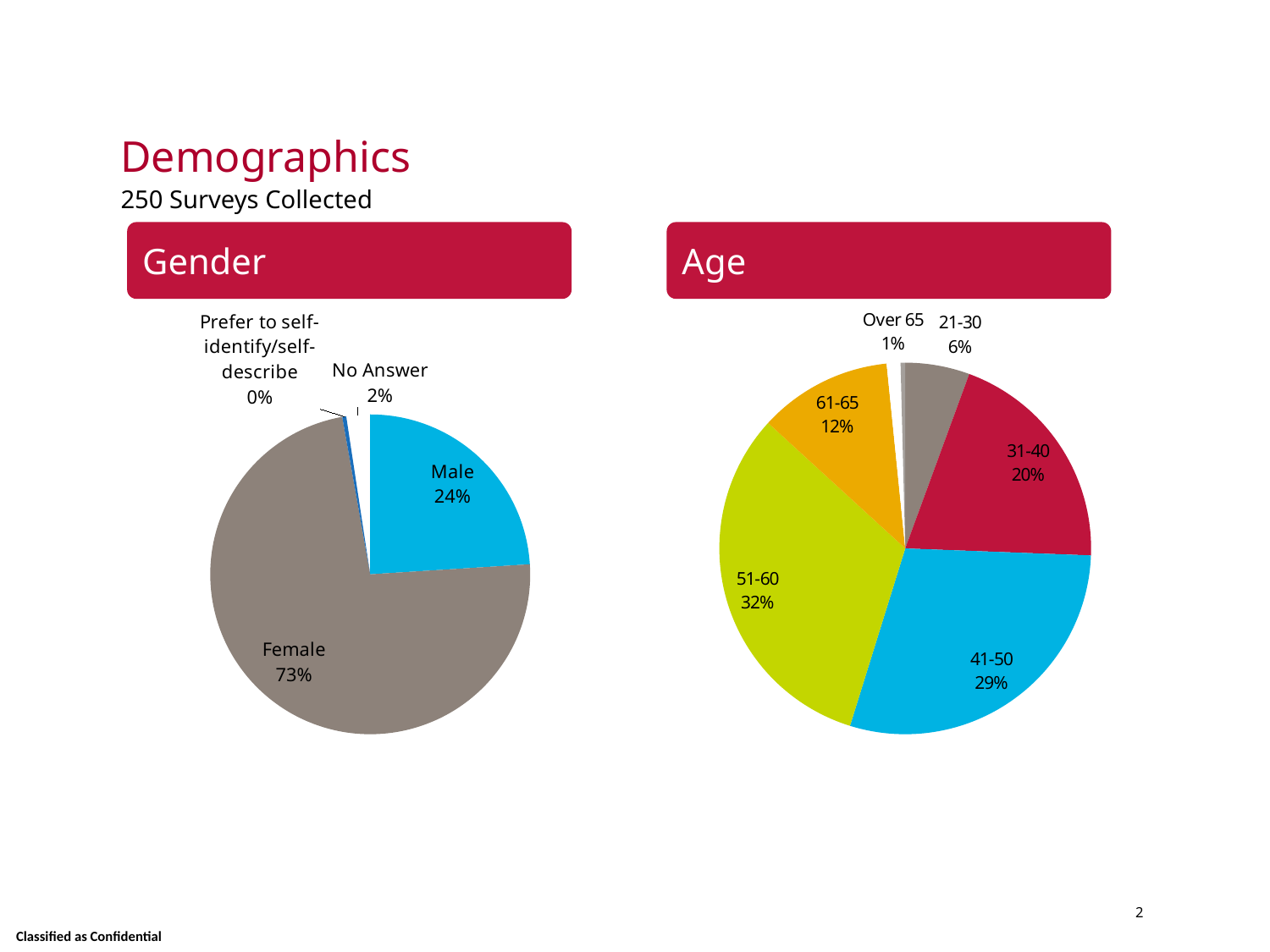
How many age groups are shown in the Age chart? 6 In the Gender chart, what percentage gave No Answer? 2% In the Age chart, what percentage of respondents are aged 41-50? 29% What type of chart is the Gender chart? Pie chart In the Gender chart, which category has the largest share? Female In the Age chart, which age group has the smallest share? Over 65 In the Gender chart, what percentage of respondents are Female? 73% In the Age chart, which age group has the largest share? 51-60 In the Age chart, which is larger, the share for 31-40 or the share for 21-30? 31-40 In the Gender chart, what is the difference between the Female and Male shares? 49% In the Gender chart, what percentage of respondents are Male? 24% In the Age chart, what percentage of respondents are aged 61-65? 12%